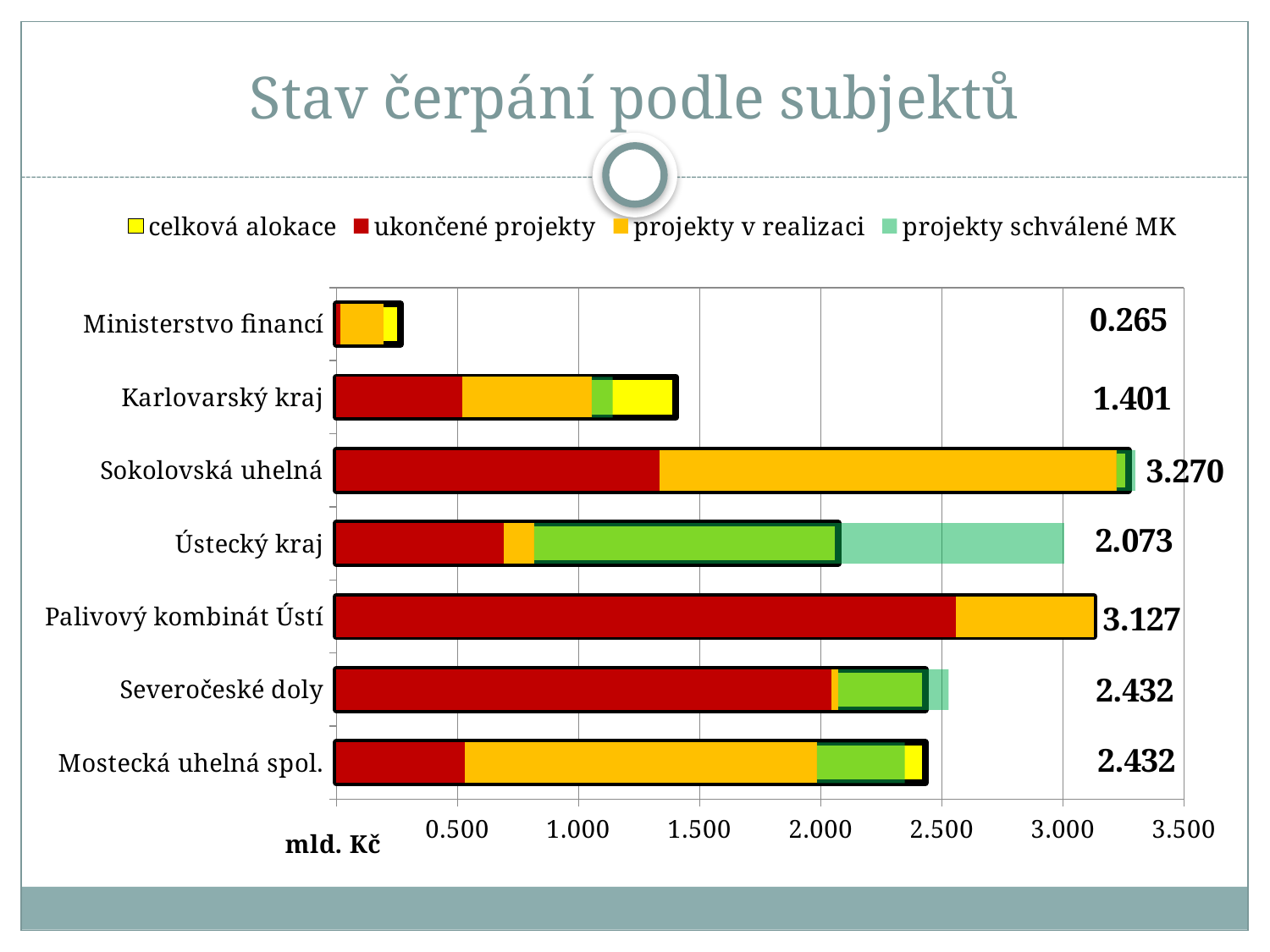
What value is labelled next to the bar for Ministerstvo financí? 0.265 How many series does the legend list? 4 What value is labelled next to the bar for Ústecký kraj? 2.073 Which subject has the lowest labelled value? Ministerstvo financí What is the difference between the labelled values for Sokolovská uhelná and Palivový kombinát Ústí? 0.143 Is the ukončené projekty (red) segment for Palivový kombinát Ústí greater or less than 2.000? greater What value is labelled next to the bar for Sokolovská uhelná? 3.270 Which subject has the highest labelled value? Sokolovská uhelná What unit is shown on the x axis of the chart? mld. Kč What kind of chart is shown on the slide? Stacked bar chart Which has the larger labelled value, Karlovarský kraj or Ústecký kraj? Ústecký kraj How many subjects (categories) are shown on the chart? 7